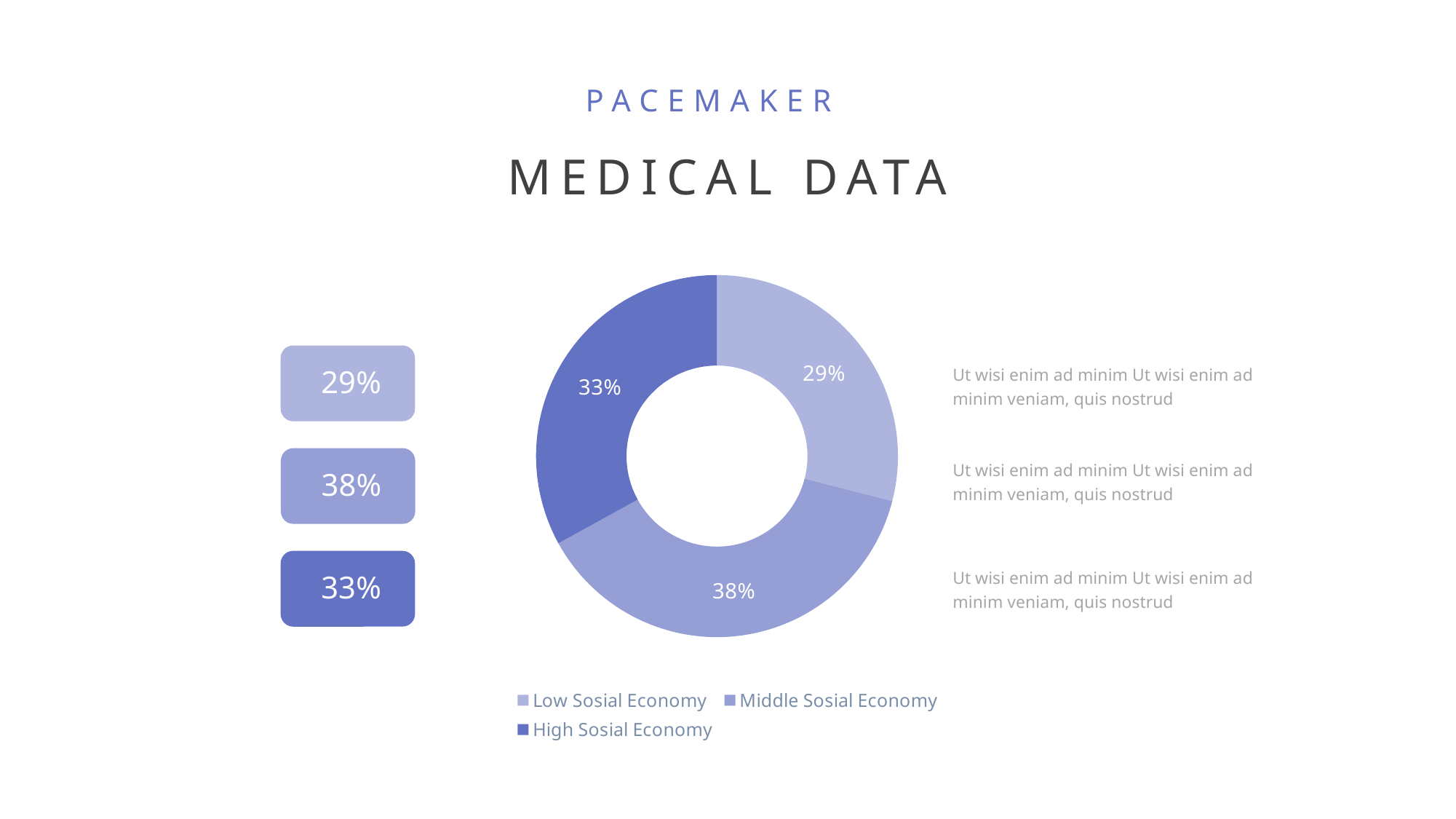
Which category has the smallest share of the chart? Low Sosial Economy How many categories does the chart show? 3 What percentage is shown for High Sosial Economy? 33% Which legend entry is shown in the darkest shade of blue? High Sosial Economy What percentage is shown for Low Sosial Economy? 29% Which category has the largest share of the chart? Middle Sosial Economy How many entries does the legend list? 3 What is the difference in percentage points between Middle Sosial Economy and Low Sosial Economy? 9 Which is larger, the share for High Sosial Economy or the share for Low Sosial Economy? High Sosial Economy What is the difference in percentage points between High Sosial Economy and Low Sosial Economy? 4 What kind of chart is shown on the slide? Doughnut chart What percentage is shown for Middle Sosial Economy? 38%